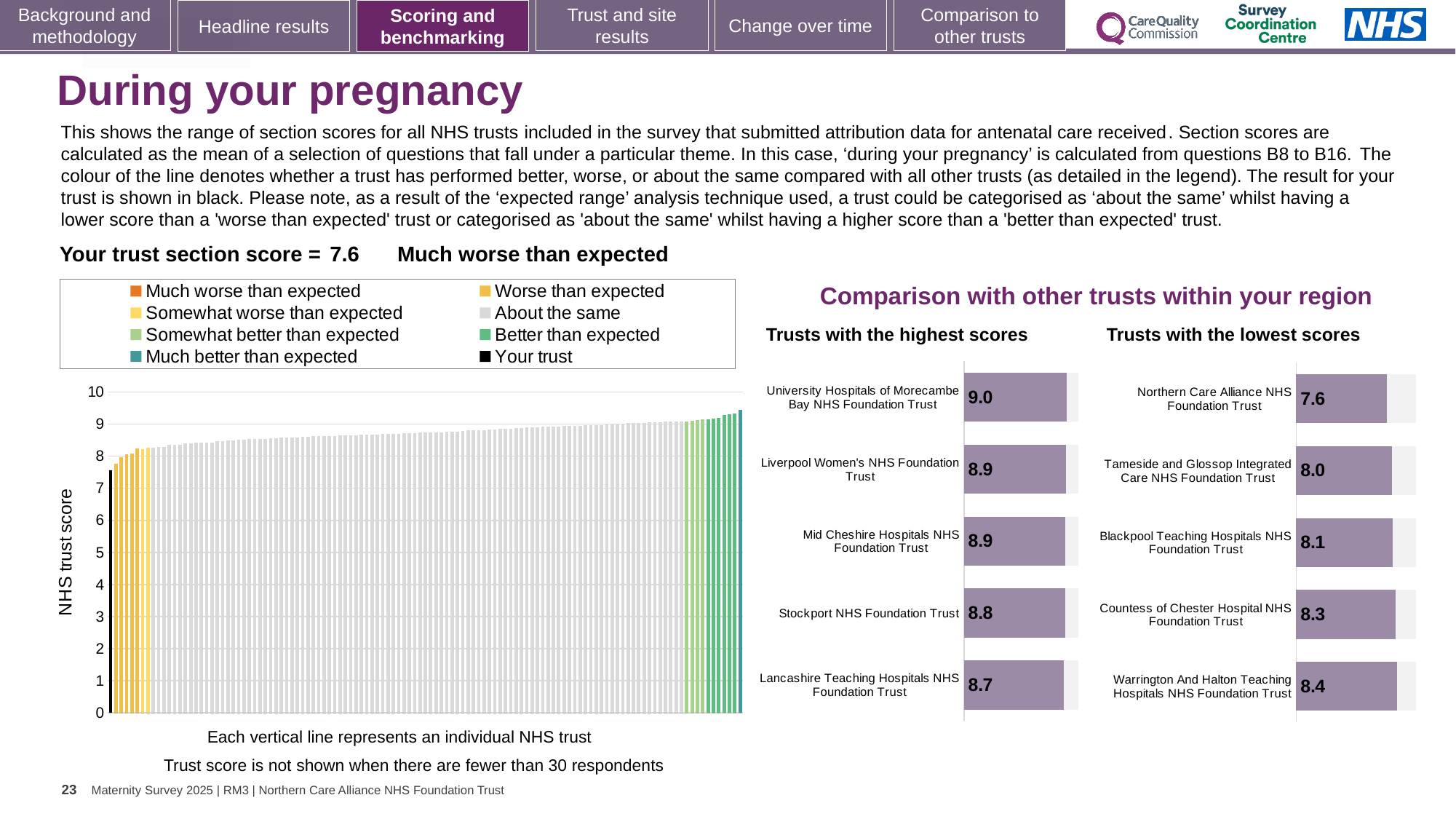
In the 'Trusts with the highest scores' chart, which has the larger score: Stockport NHS Foundation Trust or Lancashire Teaching Hospitals NHS Foundation Trust? Stockport NHS Foundation Trust In the NHS trust score chart on the left, is the value for the black 'Your trust' bar greater or less than 8? less In the 'Trusts with the highest scores' chart, how many trusts are shown? 5 In the 'Trusts with the lowest scores' chart, what is the difference between the scores of Warrington And Halton Teaching Hospitals NHS Foundation Trust and Northern Care Alliance NHS Foundation Trust? 0.8 In the 'Trusts with the highest scores' chart, which trust has the highest score? University Hospitals of Morecambe Bay NHS Foundation Trust In the 'Trusts with the highest scores' chart, what is the score for University Hospitals of Morecambe Bay NHS Foundation Trust? 9.0 In the 'Trusts with the lowest scores' chart, which trust has the lowest score? Northern Care Alliance NHS Foundation Trust What kind of chart is the NHS trust score chart on the left? Bar chart In the 'Trusts with the lowest scores' chart, what is the score for Tameside and Glossop Integrated Care NHS Foundation Trust? 8.0 In the 'Trusts with the lowest scores' chart, what is the score for Countess of Chester Hospital NHS Foundation Trust? 8.3 In the NHS trust score chart on the left, how many entries does the legend list? 8 In the NHS trust score chart on the left, do the trust scores rise or fall from left to right? Rise